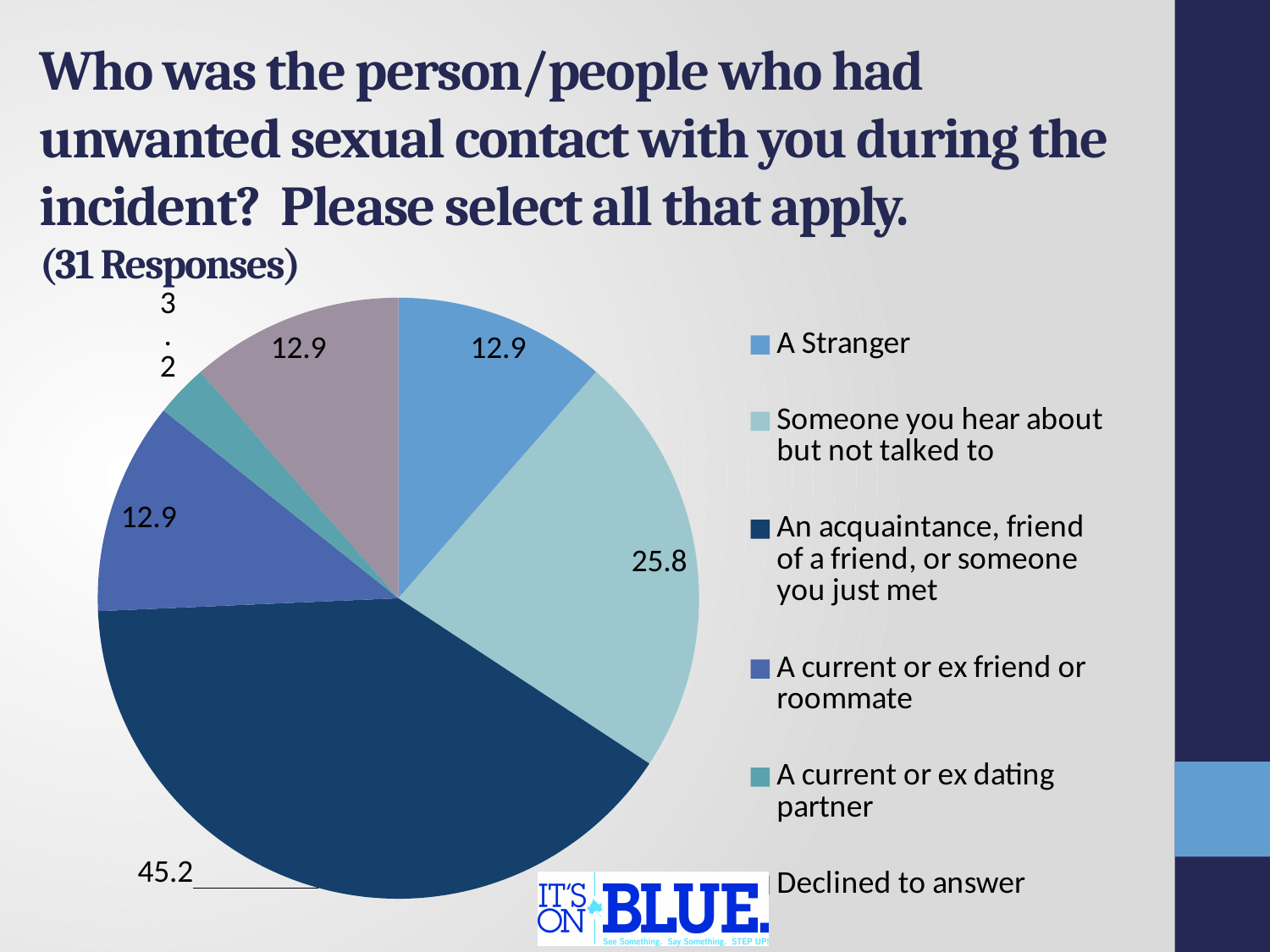
What is the value for "Someone you hear about but not talked to"? 25.8 What is the value for "An acquaintance, friend of a friend, or someone you just met"? 45.2 What is the value for "A Stranger"? 12.9 How many categories does the legend list? 6 Which is larger: the value for "Someone you hear about but not talked to" or the value for "Declined to answer"? Someone you hear about but not talked to How many slices does the pie chart have? 6 What is the value for "A current or ex dating partner"? 3.2 Which category has the smallest slice of the pie? A current or ex dating partner How many responses does the slide say the chart is based on? 31 Responses What kind of chart is shown on the slide? pie chart Which category has the largest slice of the pie? An acquaintance, friend of a friend, or someone you just met What is the difference between the values for "An acquaintance, friend of a friend, or someone you just met" and "Someone you hear about but not talked to"? 19.4